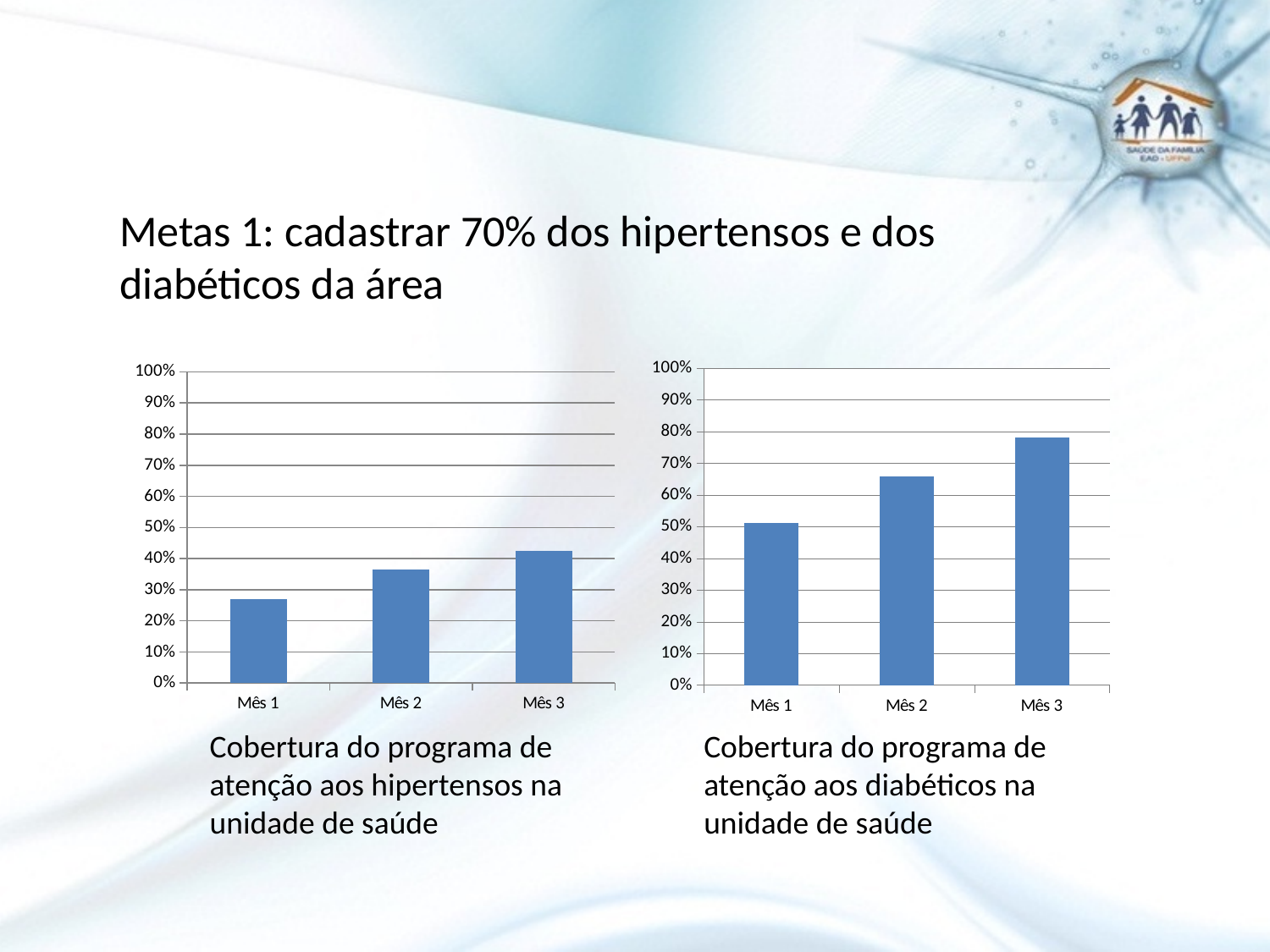
In the left chart (hipertensos), do the values rise or fall from Mês 1 to Mês 3? rise In the left chart (Cobertura do programa de atenção aos hipertensos na unidade de saúde), which month has the lowest value? Mês 1 In the left chart (hipertensos), is the value for Mês 1 greater or less than 30%? less Which chart shows the higher value for Mês 3, the hipertensos chart on the left or the diabéticos chart on the right? the diabéticos chart on the right In the left chart (hipertensos), is the value for Mês 3 greater or less than 40%? greater In the right chart (diabéticos), which is larger, the value for Mês 1 or the value for Mês 2? Mês 2 In the left chart (Cobertura do programa de atenção aos hipertensos na unidade de saúde), which month has the highest value? Mês 3 How many months are shown on the x axis of the right chart (diabéticos)? 3 In the right chart (Cobertura do programa de atenção aos diabéticos na unidade de saúde), which month has the highest value? Mês 3 What kind of chart is the left chart (hipertensos)? bar chart In the right chart (diabéticos), is the value for Mês 3 greater or less than 70%? greater